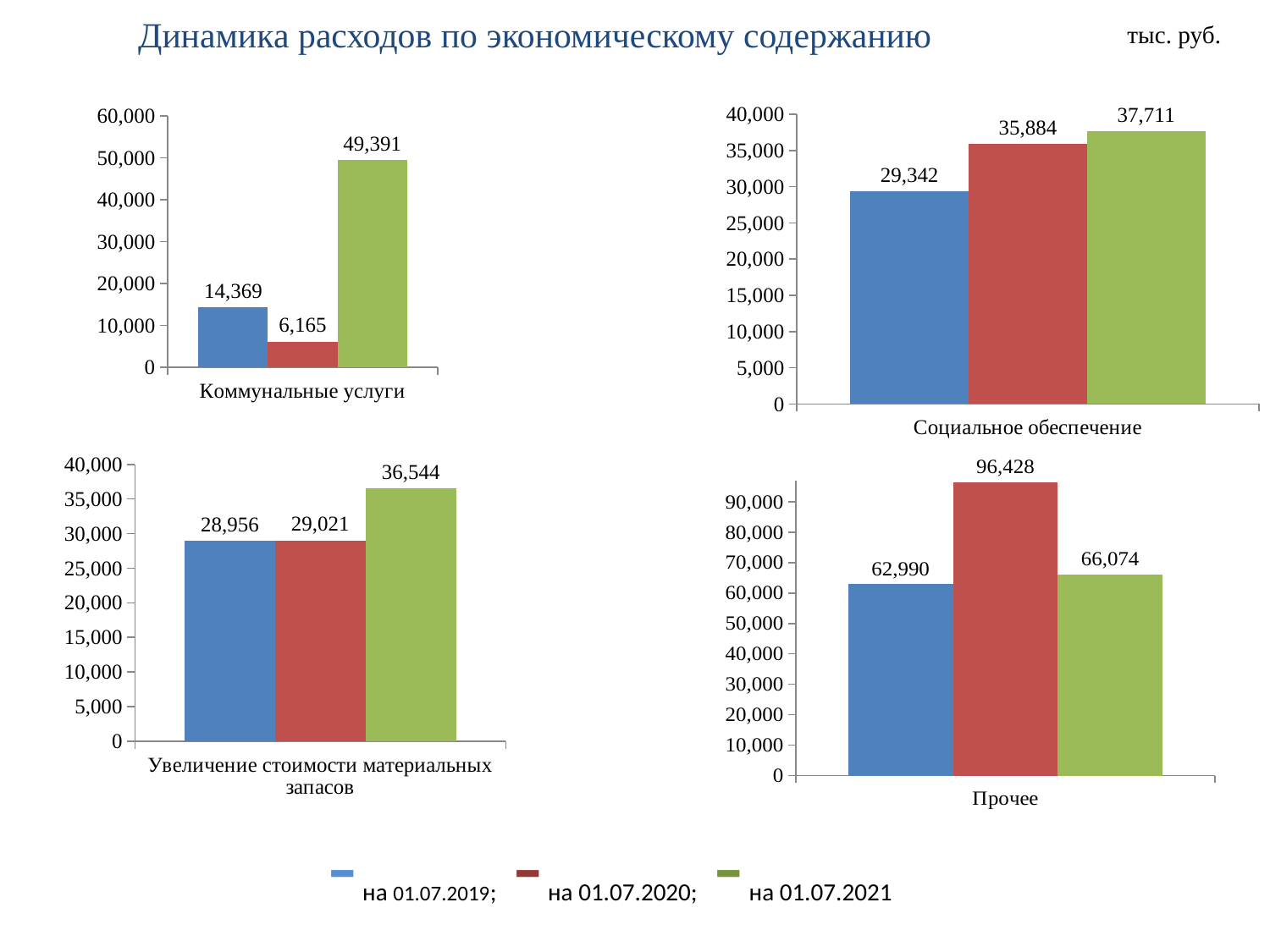
In the chart titled "Коммунальные услуги", what is the value for на 01.07.2021? 49,391 In the chart titled "Прочее", which date has the highest value? на 01.07.2020 In the chart titled "Социальное обеспечение", what is the value for на 01.07.2019? 29,342 In the chart titled "Увеличение стоимости материальных запасов", what is the value for на 01.07.2021? 36,544 What kind of chart is the chart titled "Социальное обеспечение"? bar chart In the chart titled "Прочее", what is the difference between the values for на 01.07.2020 and на 01.07.2019? 33,438 In the chart titled "Коммунальные услуги", which date has the lowest value? на 01.07.2020 In the chart titled "Социальное обеспечение", what is the difference between the values for на 01.07.2021 and на 01.07.2020? 1,827 In the chart titled "Прочее", is the value for на 01.07.2021 greater or less than 60,000? greater In the chart titled "Коммунальные услуги", which is larger: the value for на 01.07.2019 or на 01.07.2020? на 01.07.2019 In the chart titled "Увеличение стоимости материальных запасов", do the values rise or fall from на 01.07.2019 to на 01.07.2021? rise How many series does the legend at the bottom of the slide list? 3